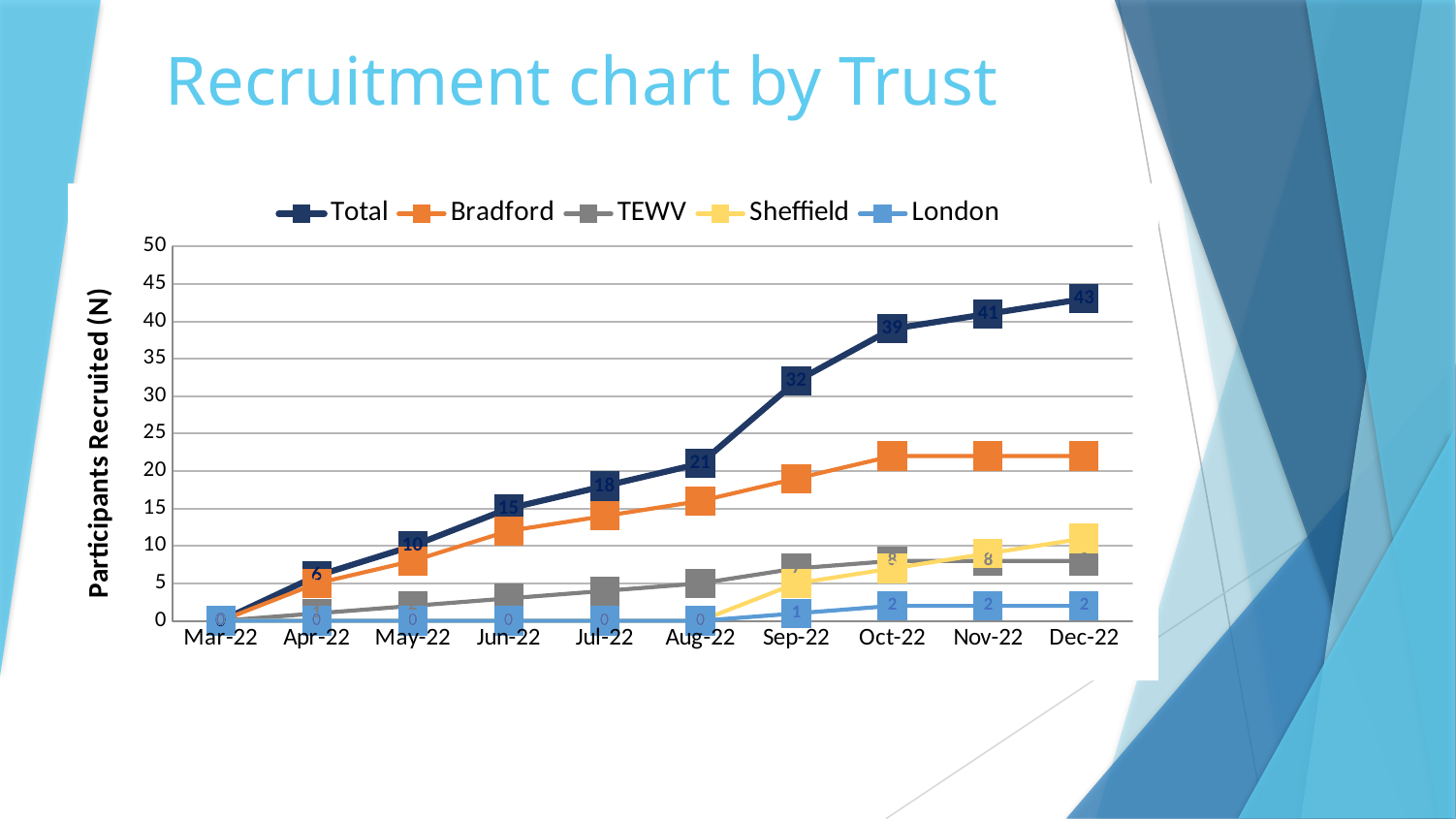
What kind of chart is shown on the slide? line chart Which is larger at Dec-22, Bradford or TEWV? Bradford Is the Bradford value for Dec-22 greater or less than 20? greater What is the Total value for Oct-22? 39 How many series does the legend list? 5 What is the London value for Dec-22? 2 How many months are shown along the x axis? 10 What is the Total value for Sep-22? 32 What is the Total value for Dec-22? 43 What is the difference between the Total values for Dec-22 and Nov-22? 2 Does the Total series rise or fall from Mar-22 to Dec-22? rise In which month is the Total value highest? Dec-22